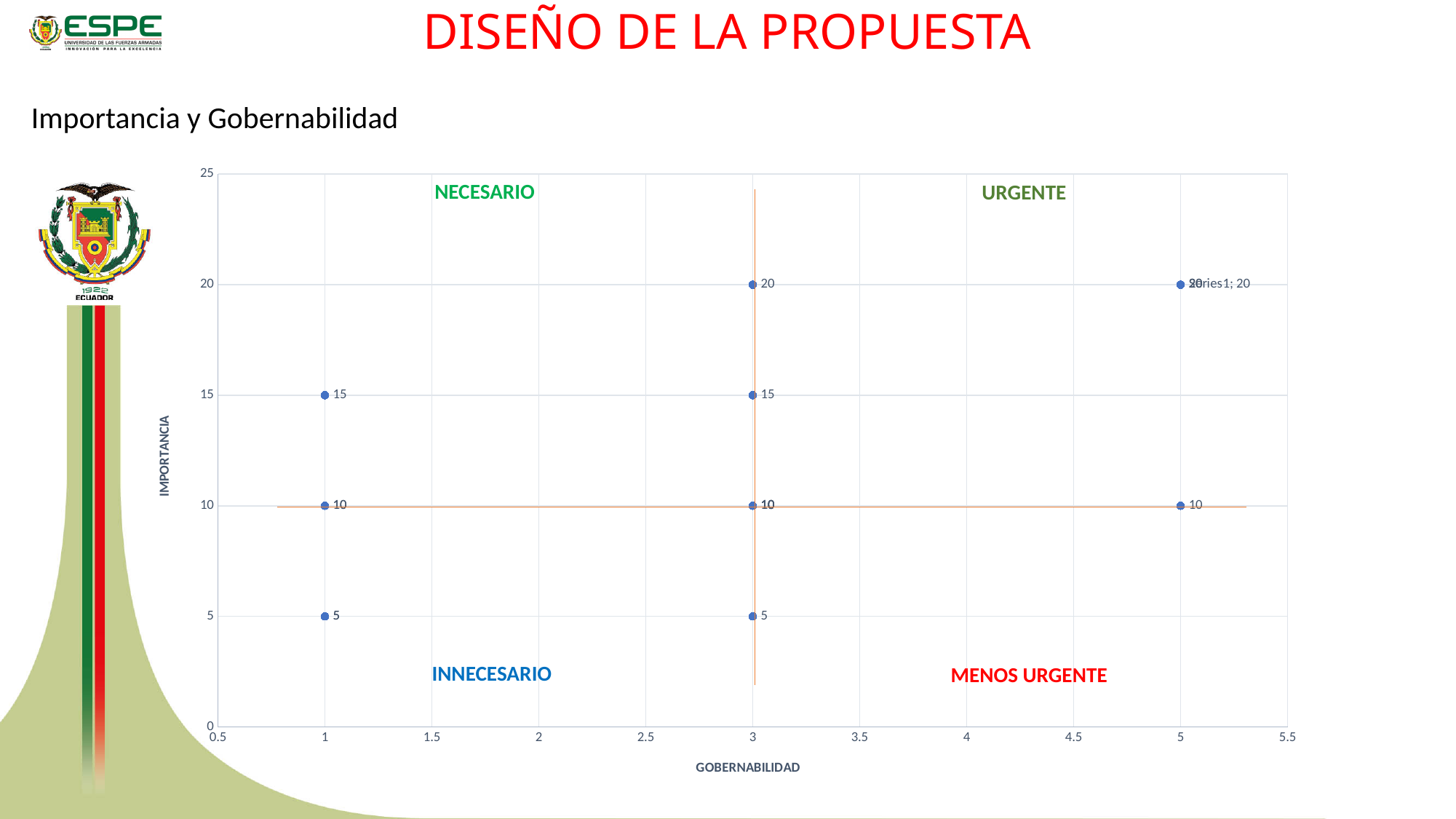
What is the title of the vertical axis of the chart? IMPORTANCIA What is the highest IMPORTANCIA value plotted at GOBERNABILIDAD = 3? 20 What is the difference between the highest and lowest IMPORTANCIA values plotted at GOBERNABILIDAD = 1? 10 What is the maximum value shown on the vertical axis of the chart? 25 What is the lowest IMPORTANCIA value plotted at GOBERNABILIDAD = 3? 5 What is the highest IMPORTANCIA value plotted at GOBERNABILIDAD = 1? 15 What is the title of the horizontal axis of the chart? GOBERNABILIDAD What is the lowest IMPORTANCIA value plotted at GOBERNABILIDAD = 5? 10 Which is larger: the highest IMPORTANCIA value at GOBERNABILIDAD = 1 or the highest IMPORTANCIA value at GOBERNABILIDAD = 5? GOBERNABILIDAD = 5 What kind of chart is shown on the slide? scatter chart